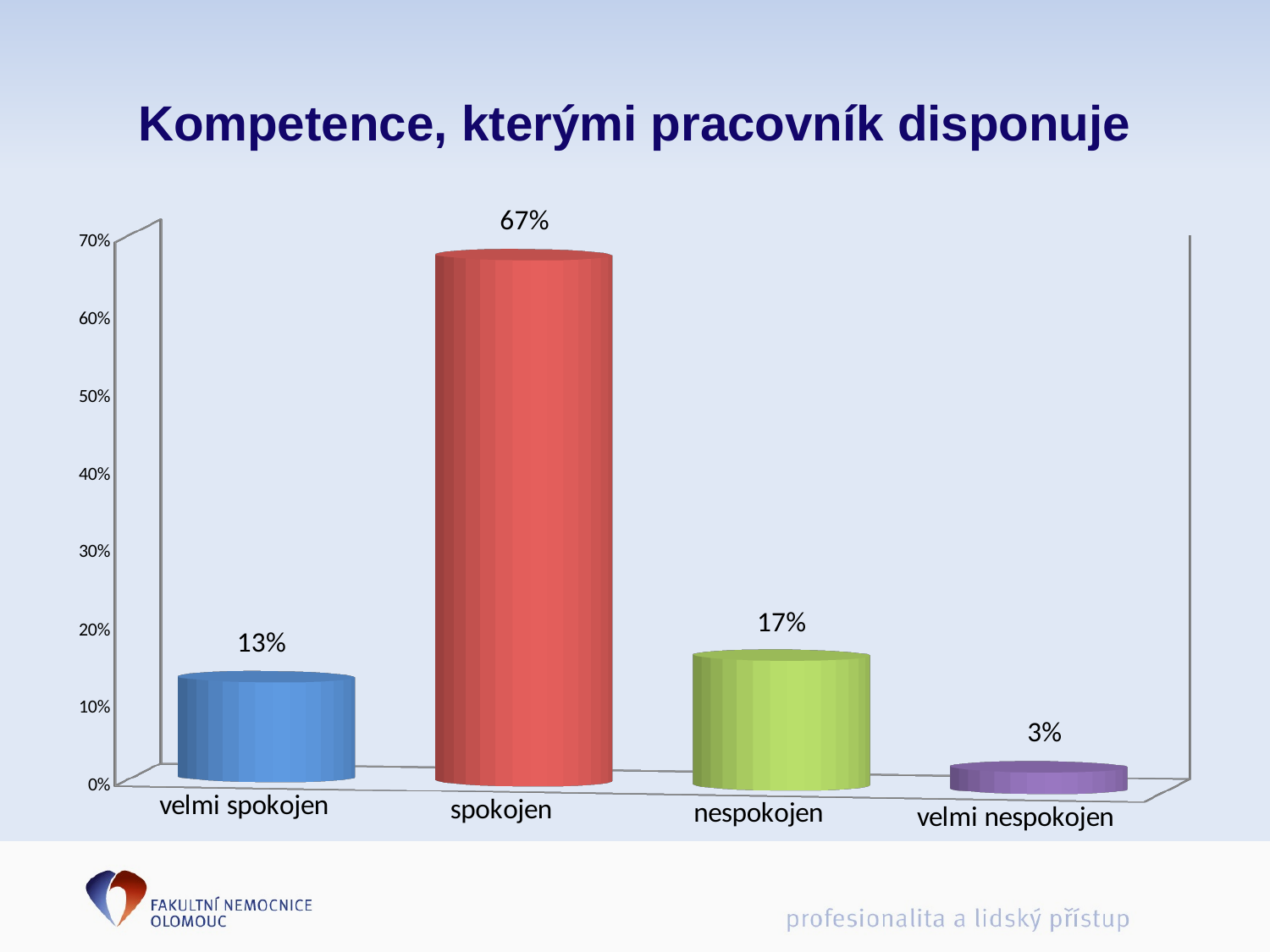
What is the value for "velmi nespokojen"? 3% What is the value for "nespokojen"? 17% What is the difference between the values for "nespokojen" and "velmi spokojen"? 4% Which category has the highest value? spokojen What is the difference between the values for "spokojen" and "nespokojen"? 50% Which is larger, the value for "velmi spokojen" or the value for "nespokojen"? nespokojen What is the value for "velmi spokojen"? 13% How many categories are shown on the chart? 4 What kind of chart is shown on the slide? bar chart Which category has the lowest value? velmi nespokojen What is the title of the chart? Kompetence, kterými pracovník disponuje What is the value for "spokojen"? 67%